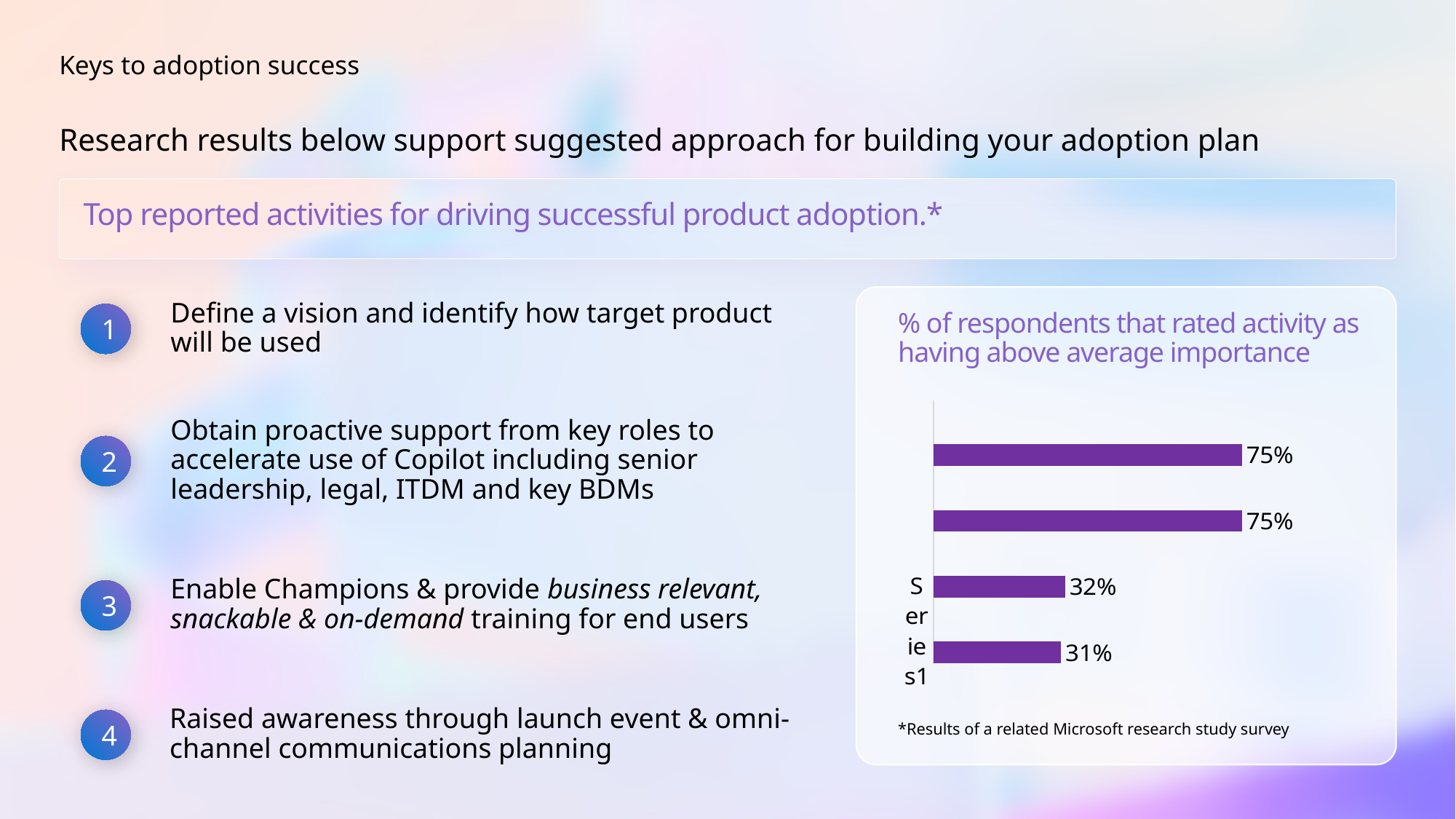
Which is larger, the value of the second bar from the top or the value of the bottom bar? the second bar from the top What is the difference between the top bar's value and the third bar's value? 43% What kind of chart is shown on the slide? bar chart What value is labelled on the top bar of the chart? 75% What value is labelled on the bottom bar of the chart? 31% Which bar has the lowest value? the bottom bar (31%) How many bars does the chart show? 4 What value is labelled on the second bar from the top? 75% What is the title of the chart? % of respondents that rated activity as having above average importance What axis label text appears to the left of the bars? Series1 What value is labelled on the third bar from the top? 32% What is the difference between the third bar's value and the bottom bar's value? 1%